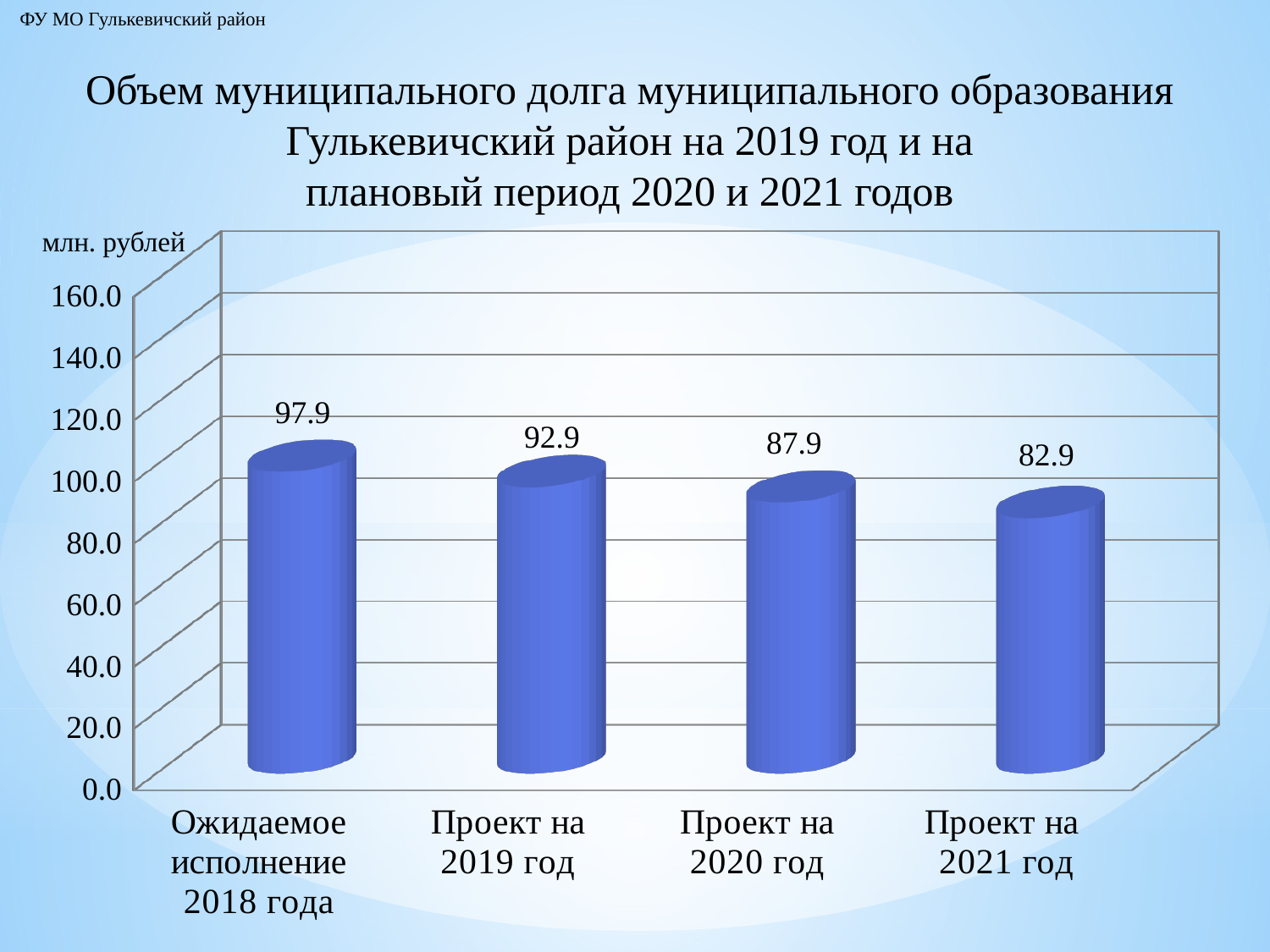
How many categories are shown on the chart? 4 What is the value for Проект на 2020 год? 87.9 What is the difference between the values for Ожидаемое исполнение 2018 года and Проект на 2021 год? 15.0 Which category has the highest value? Ожидаемое исполнение 2018 года What unit is shown on the vertical axis of the chart? млн. рублей Which category has the lowest value? Проект на 2021 год Do the values rise or fall from left to right along the x axis? Fall What is the value for Ожидаемое исполнение 2018 года? 97.9 What is the value for Проект на 2019 год? 92.9 What kind of chart is shown on the slide? Bar chart What is the value for Проект на 2021 год? 82.9 Which is larger, the value for Проект на 2019 год or Проект на 2020 год? Проект на 2019 год